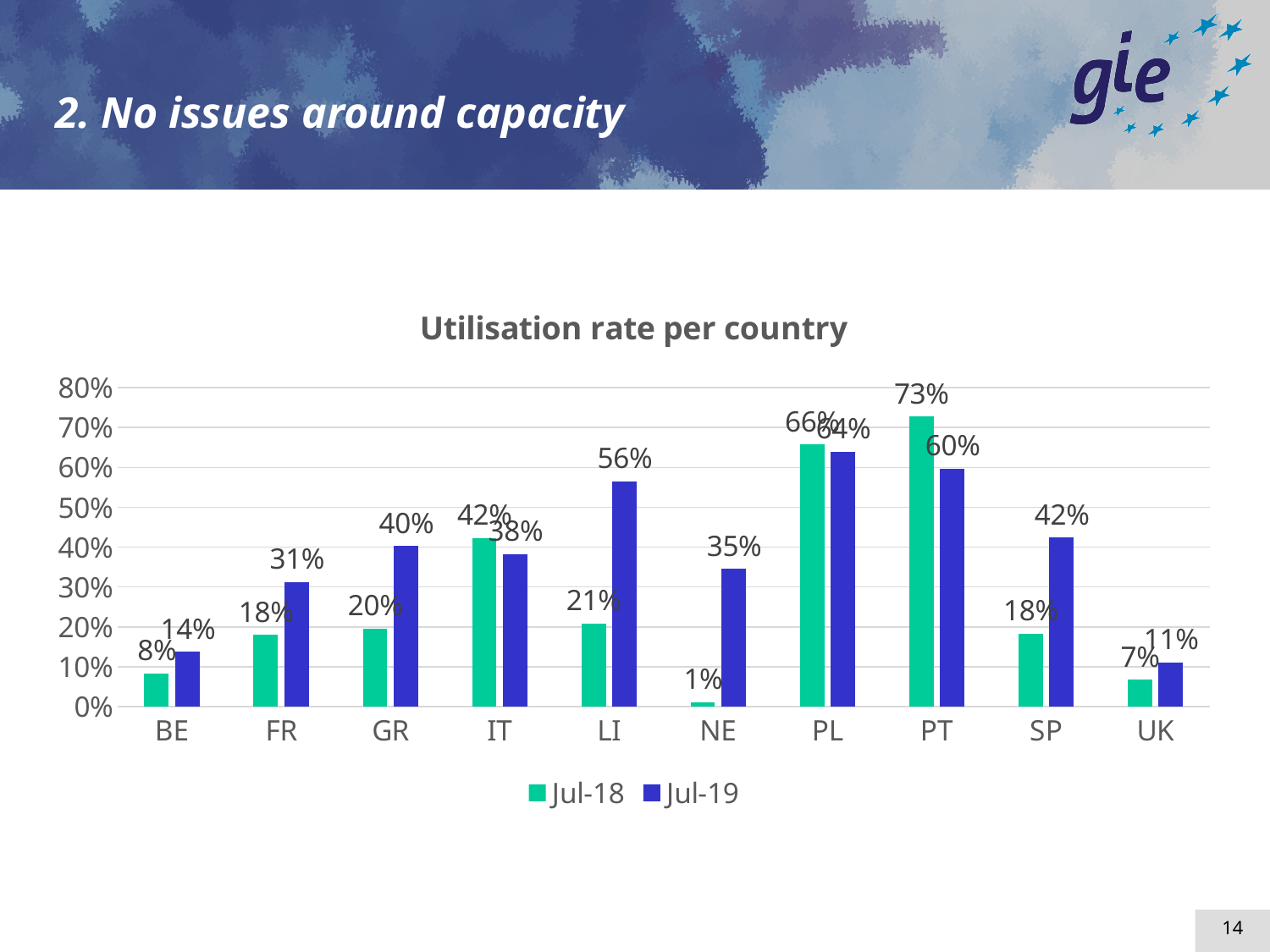
Which country has the lowest Jul-19 utilisation rate? UK Is the Jul-19 utilisation rate for FR greater or less than 40%? less How many series does the legend list? 2 What is the Jul-19 utilisation rate for SP? 42% How many countries are shown on the x axis? 10 What is the Jul-19 utilisation rate for LI? 56% What is the difference between the Jul-19 and Jul-18 utilisation rates for GR? 20% For IT, which is larger: the Jul-18 or the Jul-19 utilisation rate? Jul-18 What kind of chart is shown on the slide? Bar chart Which country has the highest Jul-18 utilisation rate? PT What is the title of the chart? Utilisation rate per country What is the Jul-18 utilisation rate for NE? 1%